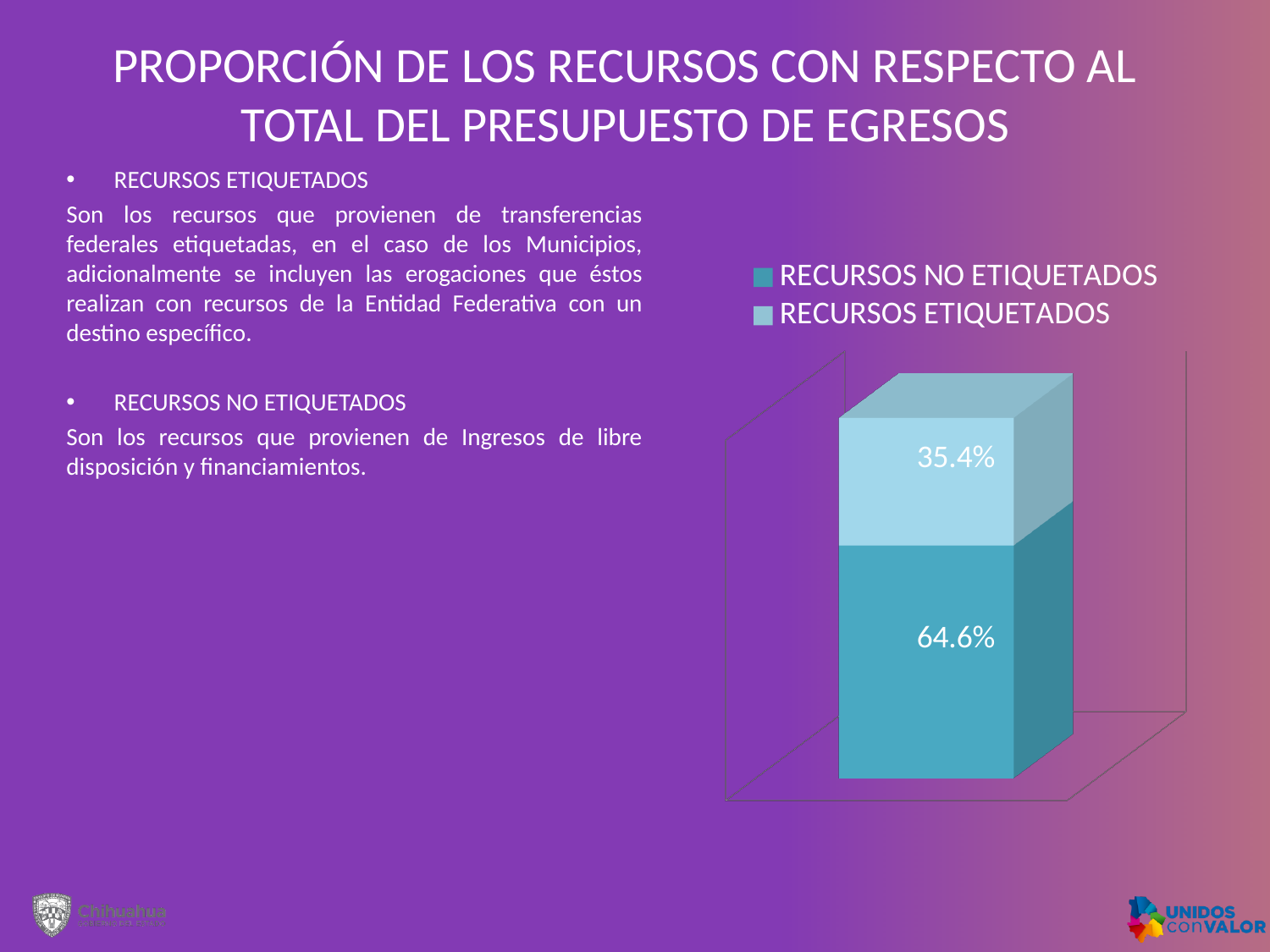
What is the difference between the RECURSOS NO ETIQUETADOS value and the RECURSOS ETIQUETADOS value? 29.2 percentage points Which series is listed first in the chart legend? RECURSOS NO ETIQUETADOS What is the total of the two segments in the stacked bar? 100% Which series has the larger share of the stacked bar? RECURSOS NO ETIQUETADOS What kind of chart is shown on the slide? stacked bar chart Which series has the smaller share of the stacked bar? RECURSOS ETIQUETADOS What value is shown for RECURSOS ETIQUETADOS in the chart? 35.4% How many bars are plotted in the chart? 1 What value is shown for RECURSOS NO ETIQUETADOS in the chart? 64.6% How many series does the chart legend list? 2 Which segment of the bar is at the bottom, RECURSOS ETIQUETADOS or RECURSOS NO ETIQUETADOS? RECURSOS NO ETIQUETADOS Is the value for RECURSOS ETIQUETADOS larger or smaller than the value for RECURSOS NO ETIQUETADOS? smaller